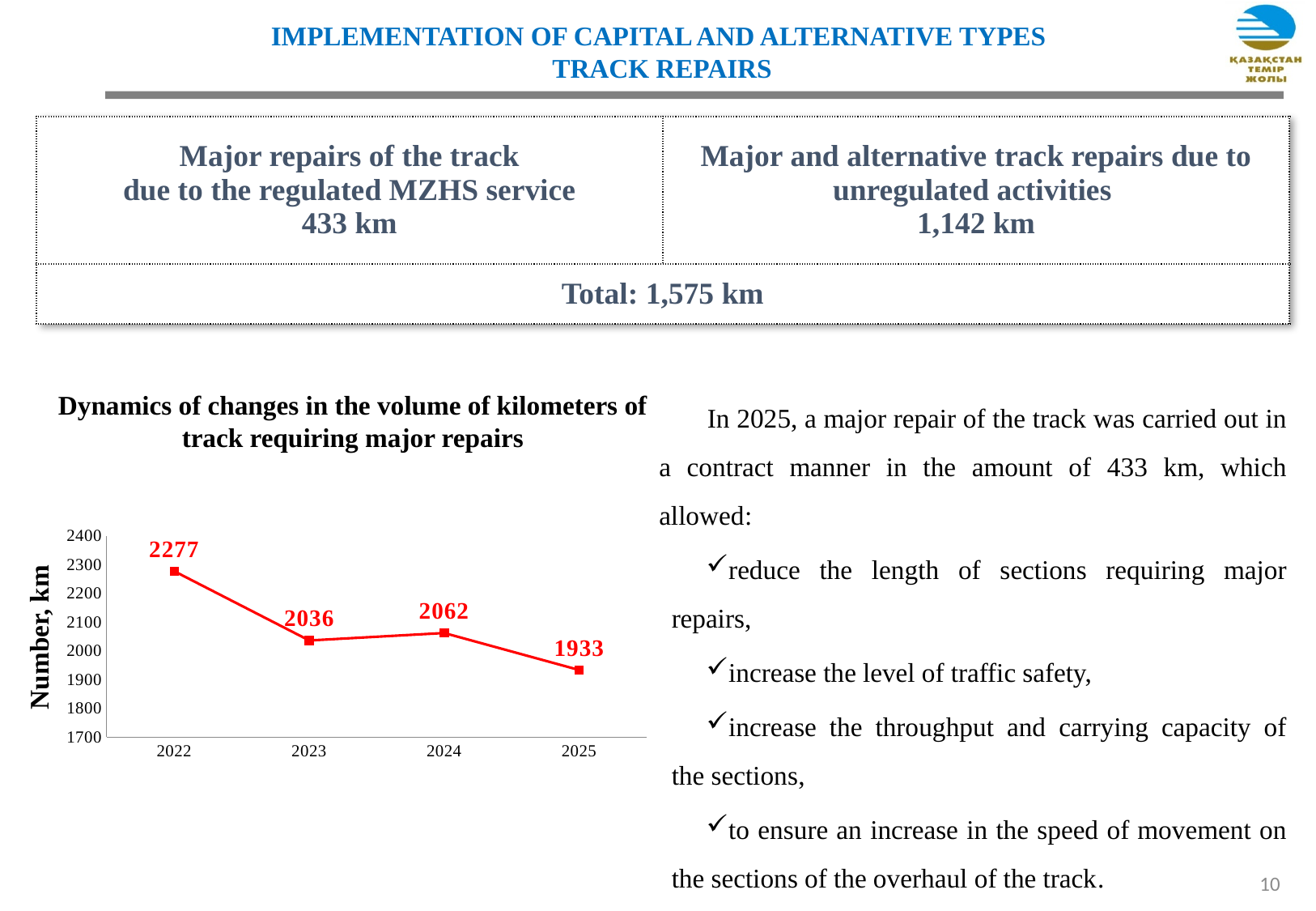
Overall, do the values in the chart of kilometers of track requiring major repairs rise or fall from 2022 to 2025? Fall What is the value for 2023 in the chart of kilometers of track requiring major repairs? 2036 How many years are plotted in the chart of kilometers of track requiring major repairs? 4 What is the label of the vertical axis in the chart of kilometers of track requiring major repairs? Number, km Which year has the lowest value in the chart of kilometers of track requiring major repairs? 2025 Which year has the highest value in the chart of kilometers of track requiring major repairs? 2022 What kind of chart shows the dynamics of kilometers of track requiring major repairs? Line chart What is the difference between the 2022 and 2025 values in the chart of kilometers of track requiring major repairs? 344 Which is larger in the chart of kilometers of track requiring major repairs, the value for 2023 or 2024? 2024 What is the value for 2025 in the chart of kilometers of track requiring major repairs? 1933 What is the value for 2022 in the chart of kilometers of track requiring major repairs? 2277 What is the value for 2024 in the chart of kilometers of track requiring major repairs? 2062